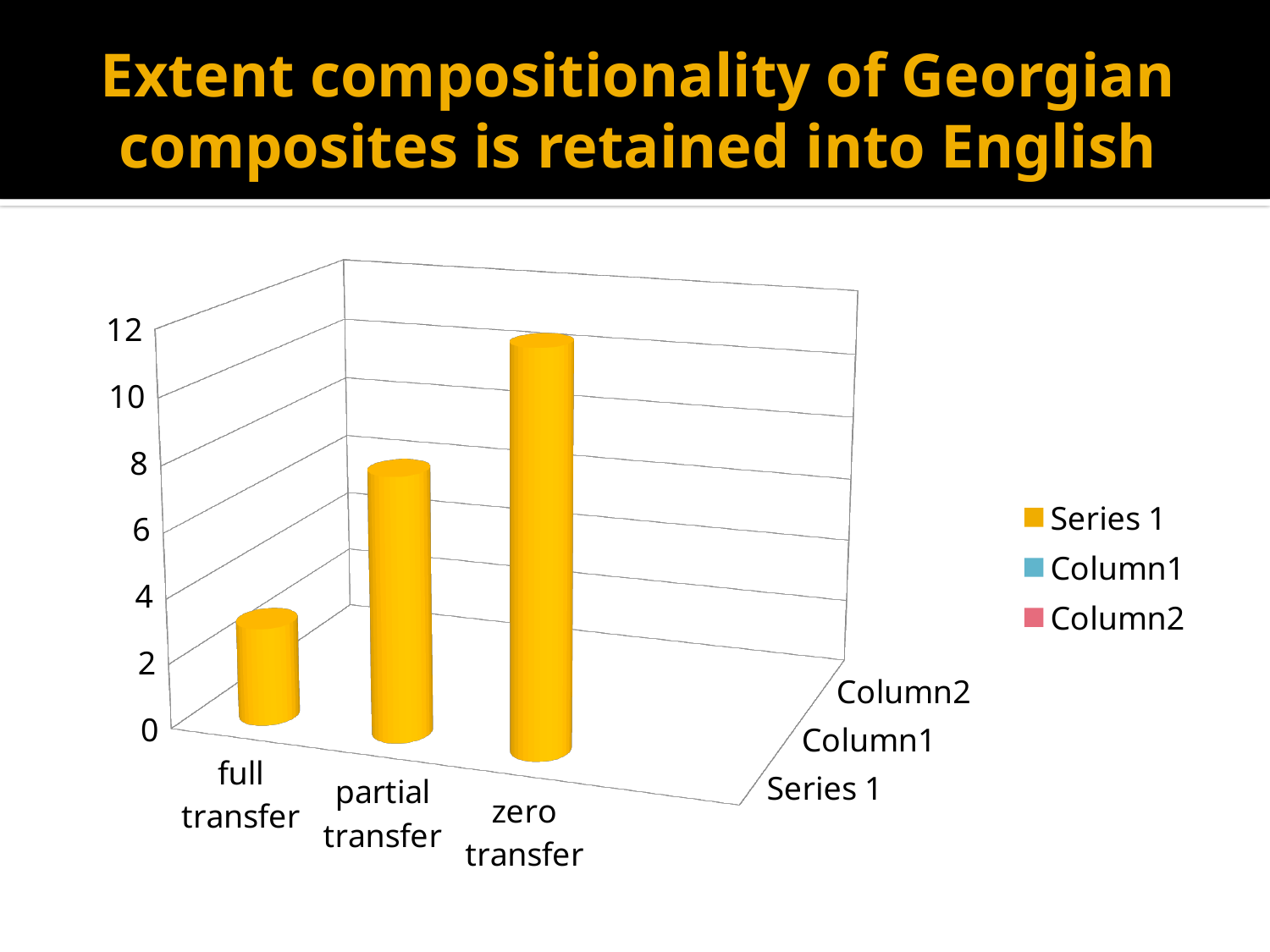
How many entries does the legend list? 3 Is the value for zero transfer greater or less than 8? greater Which is larger, the value for partial transfer or the value for full transfer? partial transfer Do the values rise or fall from full transfer to zero transfer? rise Which is larger, the value for zero transfer or the value for partial transfer? zero transfer Which category has the lowest value? full transfer Is the value for partial transfer greater or less than 4? greater Is the value for full transfer greater or less than 6? less What kind of chart is shown on the slide? bar chart Which category has the highest value? zero transfer What is the title of the slide? Extent compositionality of Georgian composites is retained into English How many categories are shown on the x axis? 3